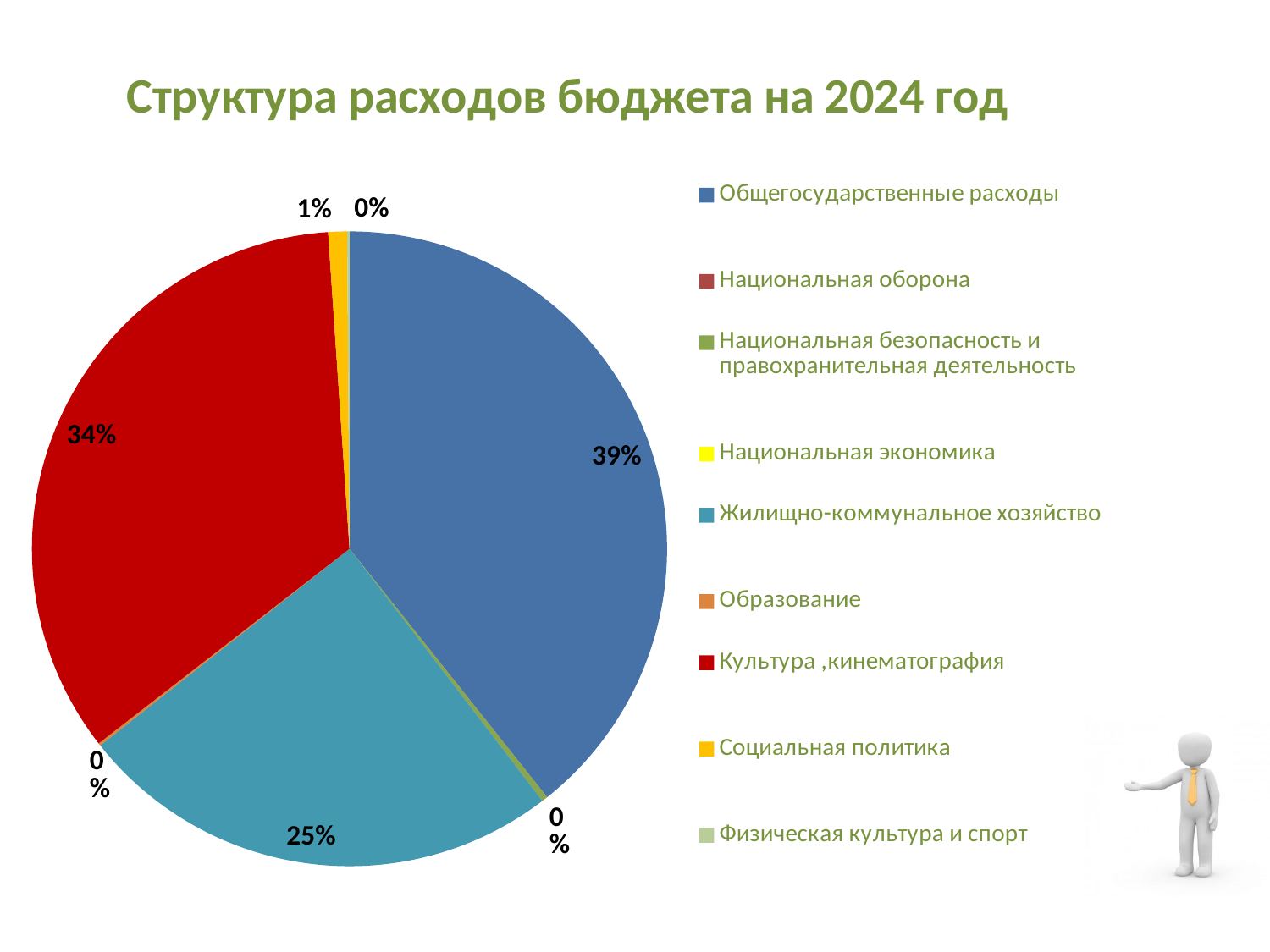
What share of the pie is Культура ,кинематография? 34% What share of the pie is Социальная политика? 1% Which category has the largest share of the pie? Общегосударственные расходы What is the difference in percentage points between Общегосударственные расходы and Культура ,кинематография? 5% What is the title of the chart? Структура расходов бюджета на 2024 год What type of chart is shown on the slide? Pie chart What share of the pie is Жилищно-коммунальное хозяйство? 25% What colour is the slice for Общегосударственные расходы? Blue How many categories does the legend list? 9 Which is larger: Культура ,кинематография or Жилищно-коммунальное хозяйство? Культура ,кинематография What is the difference in percentage points between Культура ,кинематография and Жилищно-коммунальное хозяйство? 9%